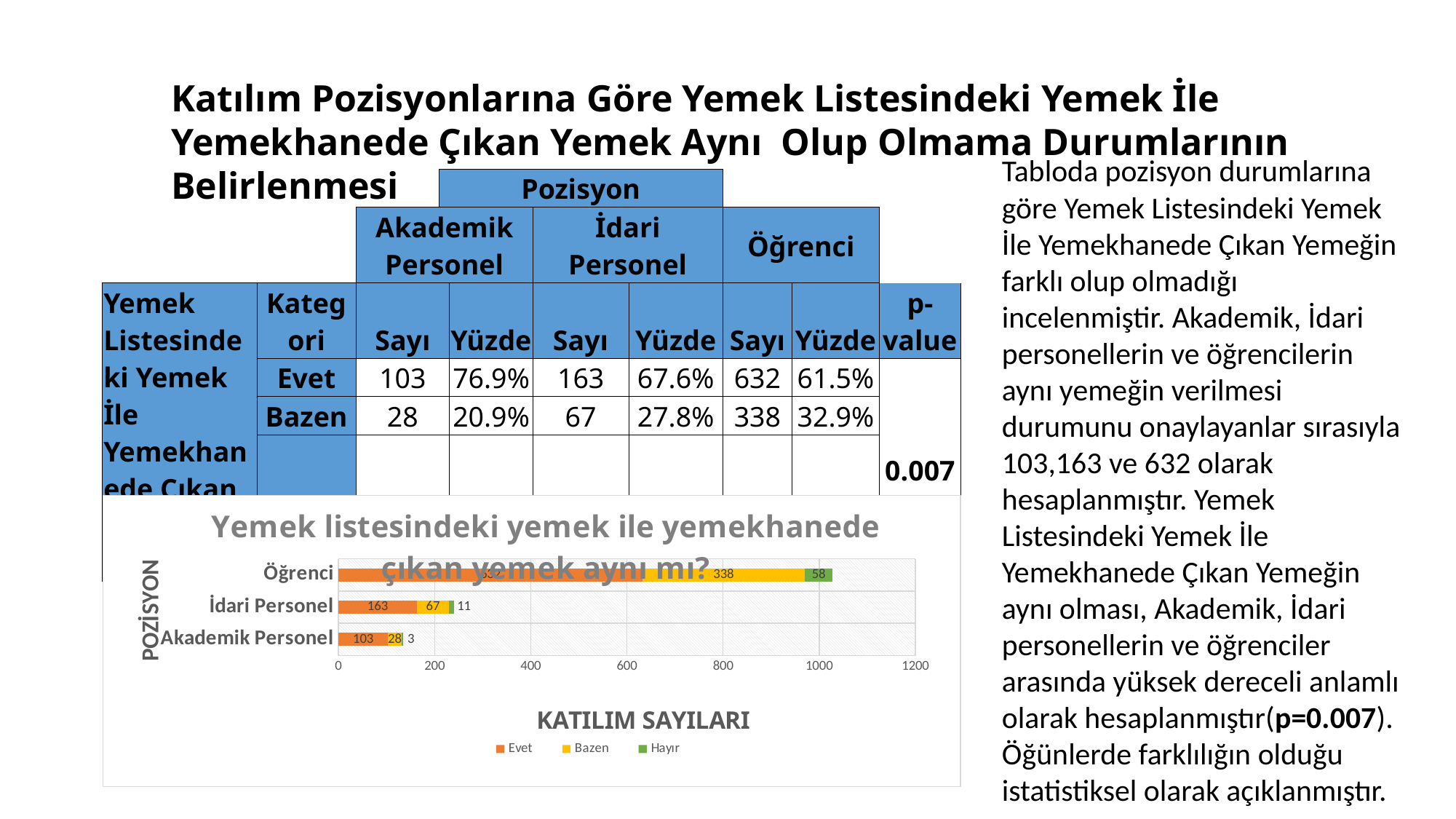
Which is larger: the Hayır value for İdari Personel or for Akademik Personel? İdari Personel Which category has the highest Bazen value in the chart? Öğrenci In the chart, what is the Bazen value for Öğrenci? 338 In the chart, what is the Hayır value for Akademik Personel? 3 What is the total of the stacked bar for İdari Personel? 241 What is the difference between the Evet values for İdari Personel and Akademik Personel? 60 In the chart, what is the Evet value for İdari Personel? 163 How many series does the chart's legend list? 3 What is the total of the stacked bar for Akademik Personel? 134 What is the title of the chart's horizontal axis? KATILIM SAYILARI How many position categories are plotted on the chart? 3 What kind of chart is shown on the slide? bar chart